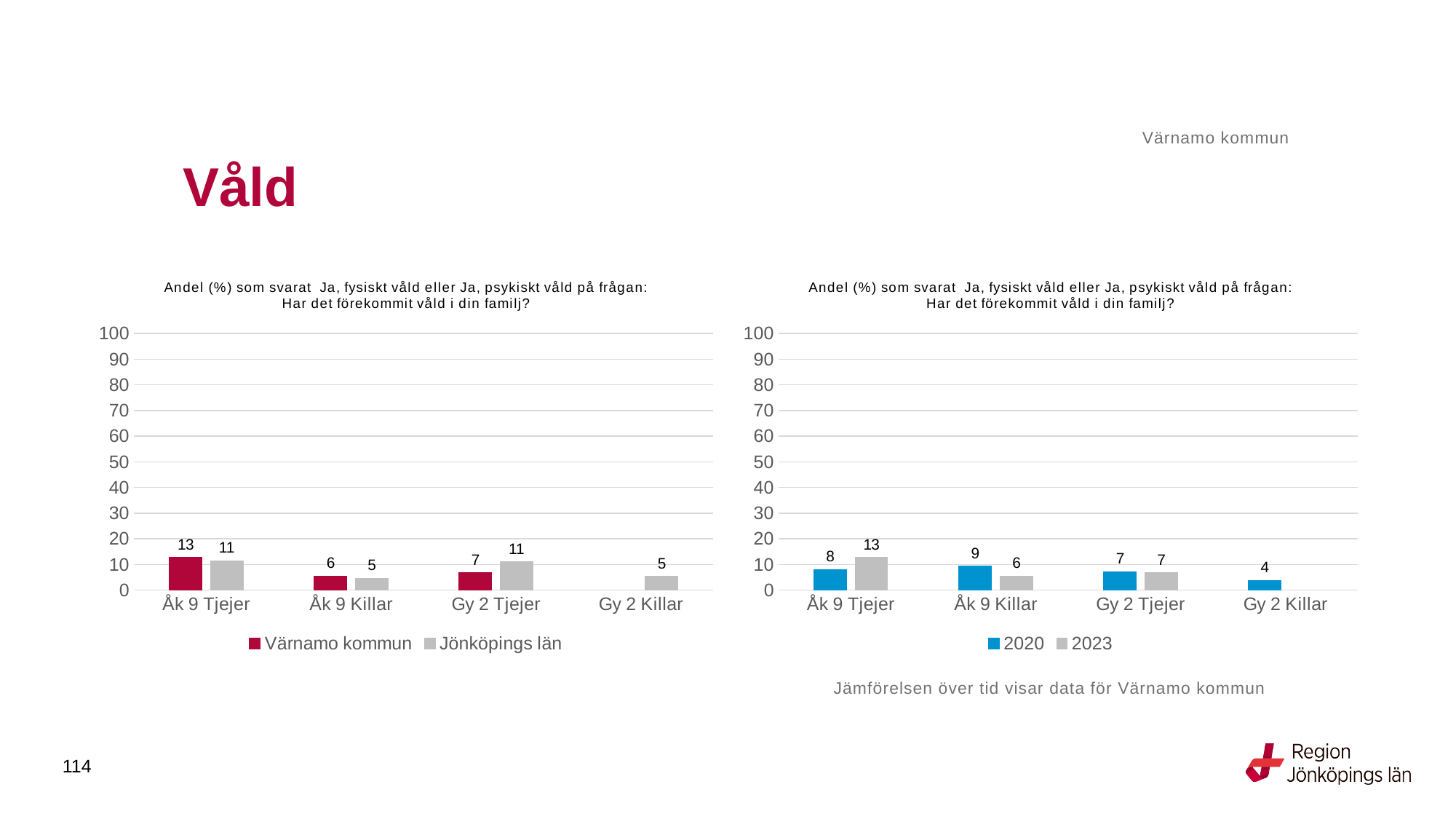
In the left chart, how many series does the legend list? 2 In the right chart, what is the value for 2020 for Gy 2 Killar? 4 In the left chart, what is the value for Jönköpings län for Gy 2 Tjejer? 11 What kind of chart is the right chart? Bar chart In the left chart, which is larger for Åk 9 Killar: Värnamo kommun or Jönköpings län? Värnamo kommun In the right chart, what is the difference between 2020 and 2023 for Åk 9 Killar? 3 In the left chart, what is the difference between Värnamo kommun and Jönköpings län for Gy 2 Tjejer? 4 In the left chart, what is the value for Värnamo kommun for Åk 9 Tjejer? 13 In the left chart, which category has the highest value for Värnamo kommun? Åk 9 Tjejer In the right chart, how many categories are shown on the x axis? 4 In the right chart, what is the value for 2023 for Åk 9 Tjejer? 13 In the right chart, which category has the lowest value for 2020? Gy 2 Killar